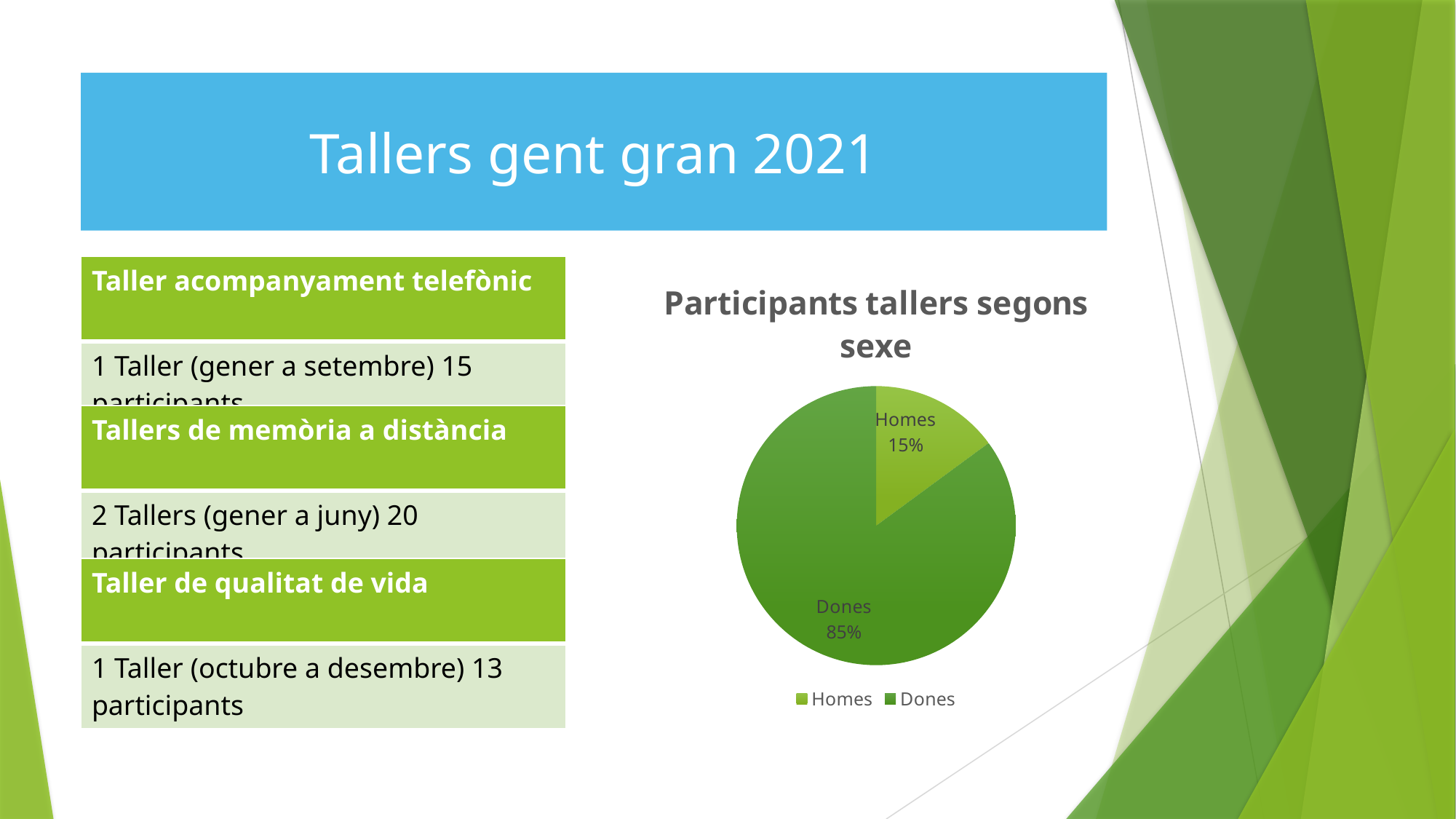
What is the difference in percentage points between the Dones and Homes slices? 70 What share of the pie does Homes represent? 15% Which is larger, the Homes slice or the Dones slice? Dones What share of the pie does Dones represent? 85% What is the title of the chart? Participants tallers segons sexe Which slice of the pie is the largest? Dones How many slices does the pie chart have? 2 Which slice of the pie is the smallest? Homes Which legend entry is shown in the lighter green colour? Homes What kind of chart is shown on the slide? pie chart How many entries does the legend list? 2